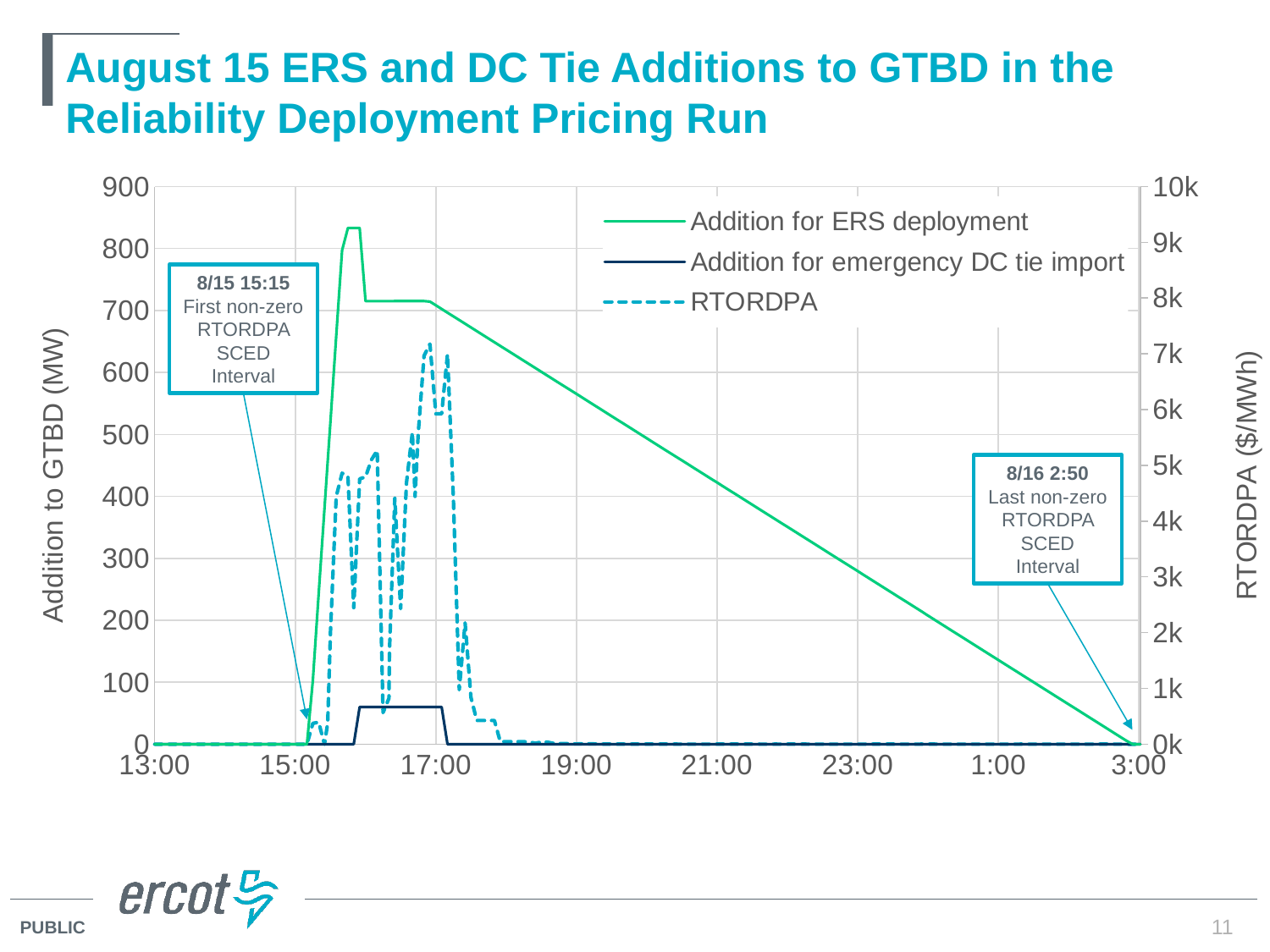
Is the peak value of the Addition for emergency DC tie import series greater or less than 100 MW? less Is the peak value of the RTORDPA series greater or less than 6k $/MWh? greater Which series is drawn with a dashed line? RTORDPA Does the Addition for ERS deployment series rise or fall between 17:00 and 3:00? Fall What is the title of the left vertical axis? Addition to GTBD (MW) Is the peak value of the Addition for ERS deployment series greater or less than 800 MW? greater According to the annotation, at what time was the first non-zero RTORDPA SCED interval? 8/15 15:15 According to the annotation, at what time was the last non-zero RTORDPA SCED interval? 8/16 2:50 Which series reaches a higher peak on the left axis, Addition for ERS deployment or Addition for emergency DC tie import? Addition for ERS deployment What is the value of the Addition for ERS deployment series at 13:00? 0 How many series does the legend list? 3 What kind of chart is shown on the slide? Line chart